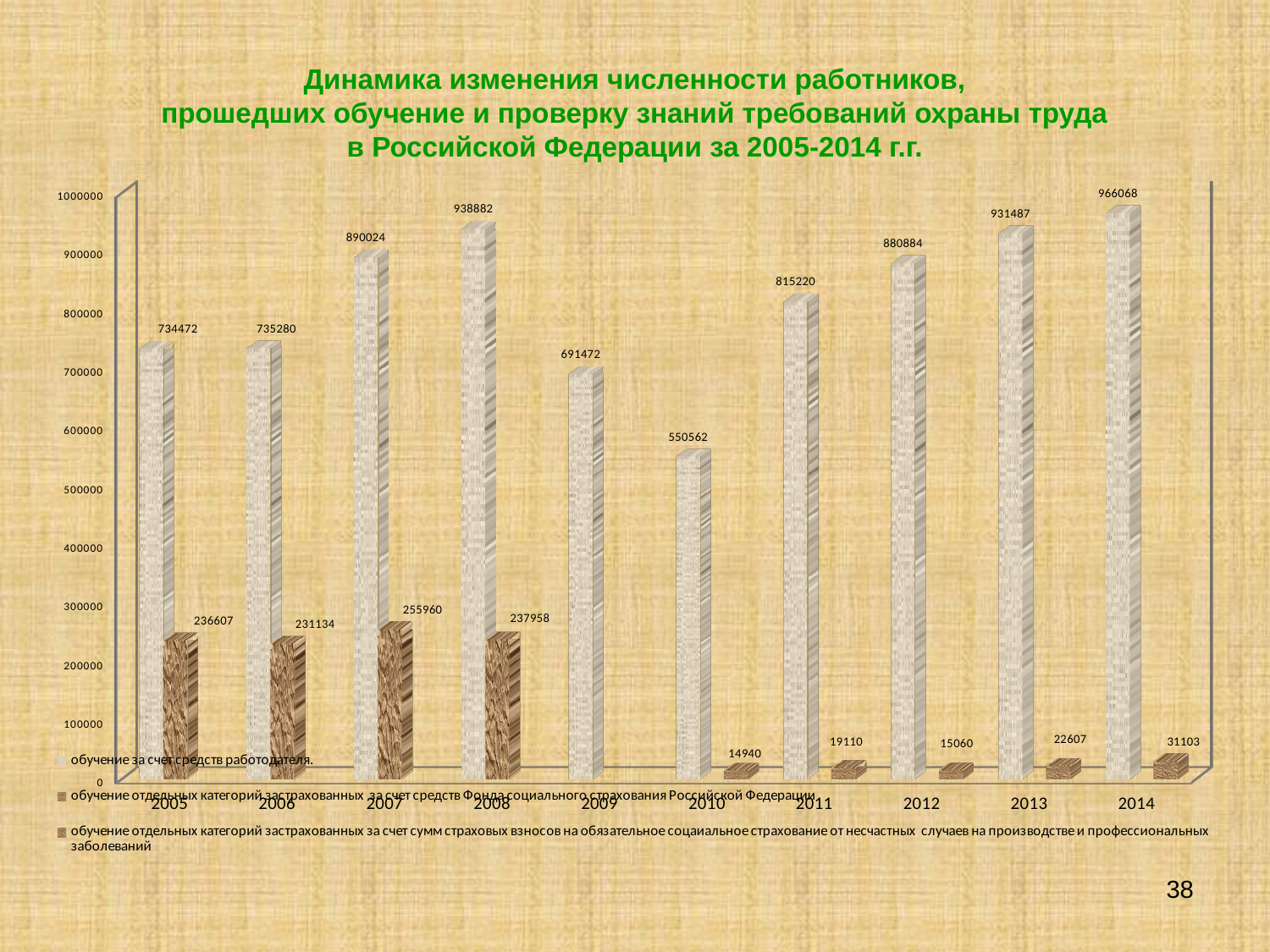
Which year has the lowest value in the series "обучение за счет средств работодателя"? 2010 Do the values of the series "обучение за счет средств работодателя" rise or fall from 2010 to 2014? rise Which year has the larger value in the series "обучение отдельных категорий застрахованных за счет средств Фонда социального страхования Российской Федерации": 2007 or 2008? 2007 What is the value for 2007 in the series "обучение отдельных категорий застрахованных за счет средств Фонда социального страхования Российской Федерации"? 255960 How many series does the chart legend list? 3 What is the difference between the 2014 and 2013 values in the series "обучение за счет средств работодателя"? 34581 How many years are shown on the x axis of the chart? 10 What is the value for 2010 in the series "обучение за счет средств работодателя"? 550562 Which year has the highest value in the series "обучение за счет средств работодателя"? 2014 What is the value for 2014 in the series "обучение за счет средств работодателя"? 966068 What type of chart is shown on the slide? bar chart What is the value for 2014 in the series "обучение отдельных категорий застрахованных за счет сумм страховых взносов на обязательное социальное страхование от несчастных случаев на производстве и профессиональных заболеваний"? 31103